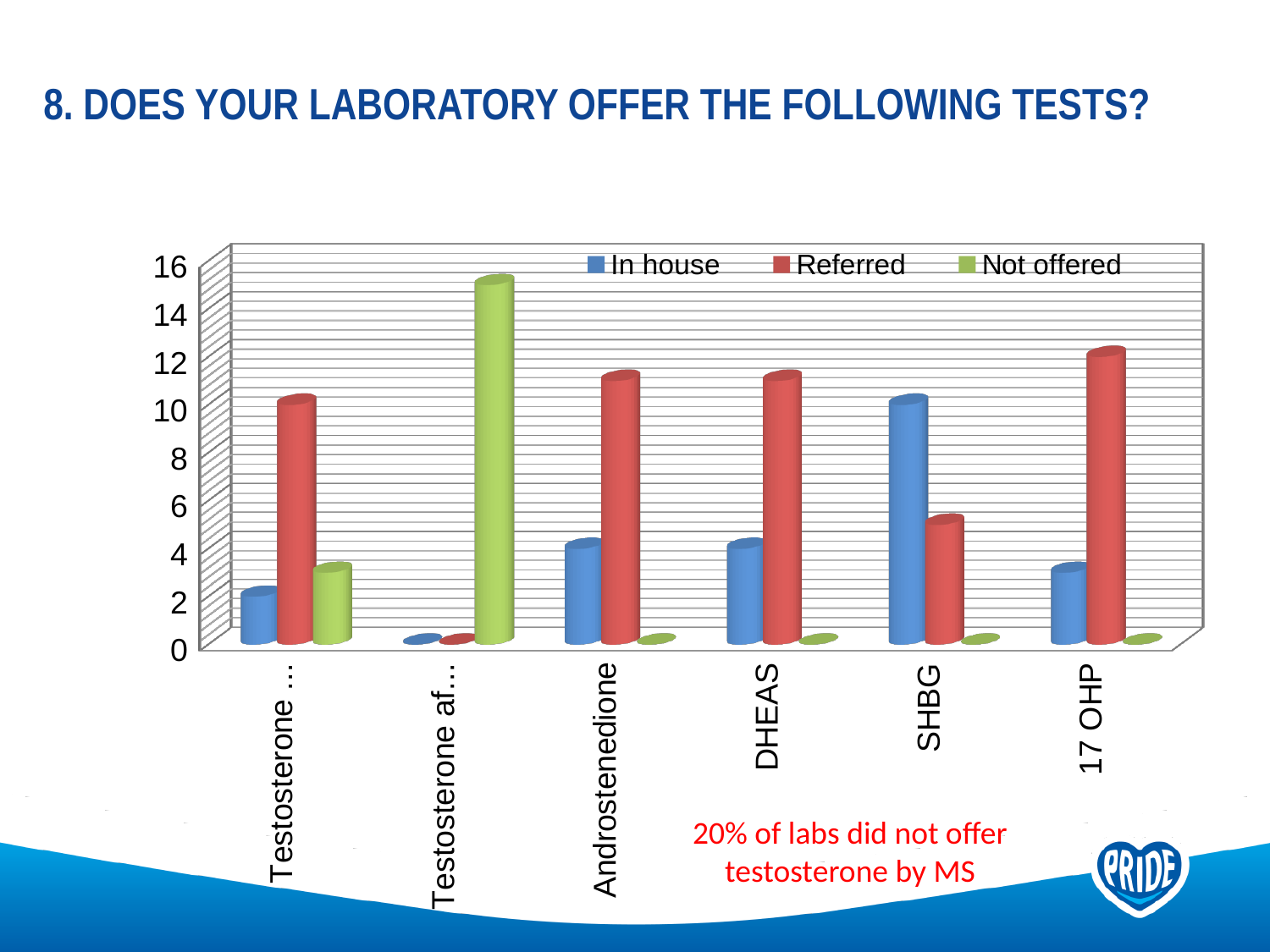
How many series does the legend list? 3 Which category has the highest In house value? SHBG Which series has the highest value for DHEAS? Referred Is the Not offered value for the second category from the left greater or less than 14? greater For SHBG, which is larger: the In house value or the Referred value? In house For Androstenedione, which is larger: the In house value or the Referred value? Referred Is the Referred value for SHBG greater or less than 8? less Is the Referred value for 17 OHP greater or less than 10? greater What are the three series named in the legend? In house, Referred, Not offered How many test categories are shown along the x axis? 6 What kind of chart is shown on the slide? bar chart